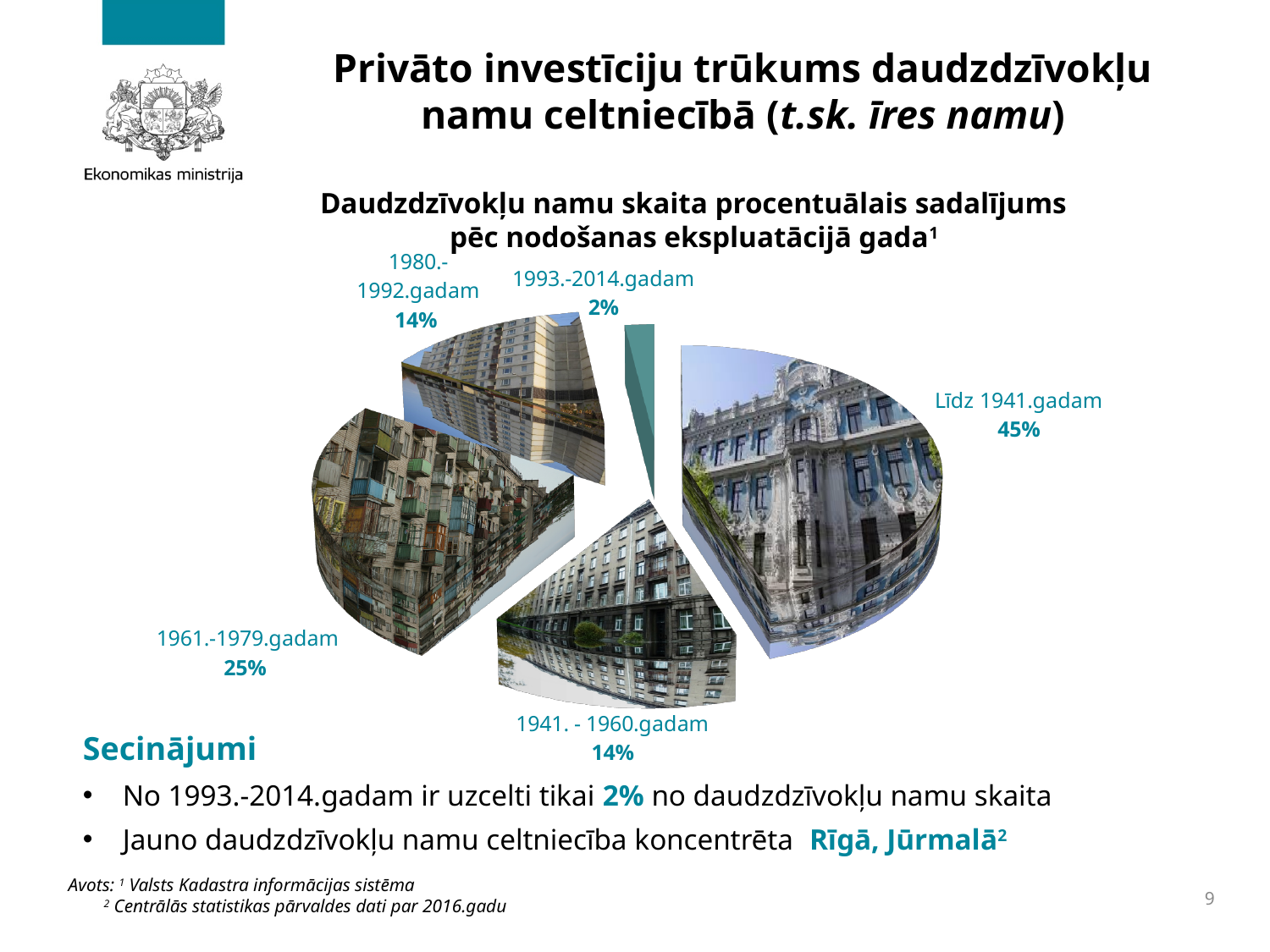
What is the title of the pie chart? Daudzdzīvokļu namu skaita procentuālais sadalījums pēc nodošanas ekspluatācijā gada How many slices does the pie chart have? 5 Which slice is larger: 1961.-1979.gadam or 1980.-1992.gadam? 1961.-1979.gadam What is the difference in percentage points between the Līdz 1941.gadam slice and the 1961.-1979.gadam slice? 20 percentage points Which period has the largest share of the pie? Līdz 1941.gadam Which period has the smallest share of the pie? 1993.-2014.gadam What share of multi-apartment buildings were put into operation before 1941 (Līdz 1941.gadam)? 45% What percentage is shown for the 1941. - 1960.gadam slice? 14% What percentage is shown for the 1961.-1979.gadam slice? 25% What percentage is shown for the 1980.-1992.gadam slice? 14% What kind of chart is shown on the slide? pie chart What percentage is shown for the 1993.-2014.gadam slice? 2%